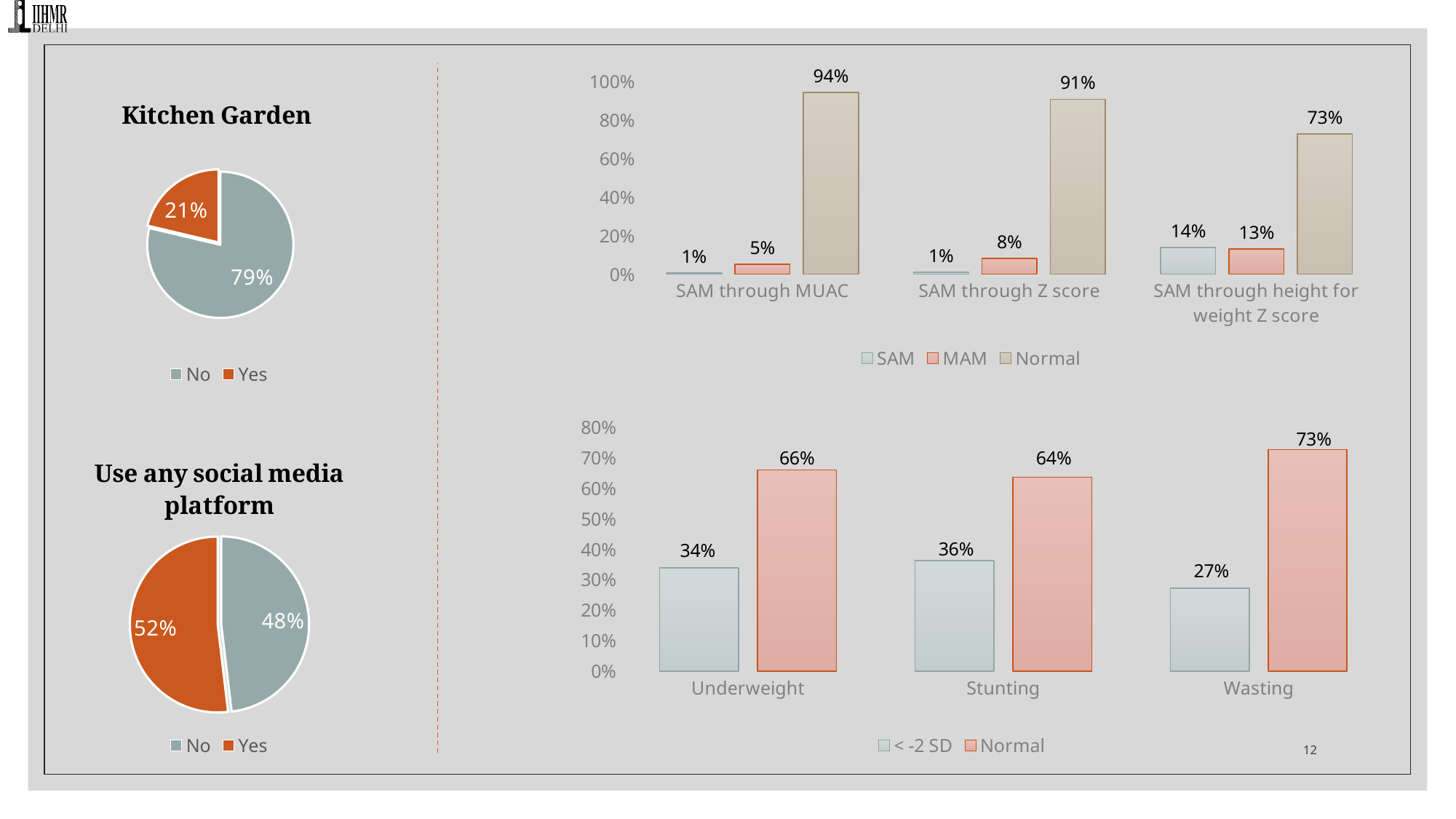
What kind of chart is the bottom-right chart? Bar chart In the top-right bar chart, what is the SAM value for SAM through height for weight Z score? 14% In the bottom-right bar chart, which category has the highest Normal value? Wasting In the top-right bar chart, what is the Normal value for SAM through MUAC? 94% In the top-right bar chart, what is the difference between the Normal values for SAM through MUAC and SAM through height for weight Z score? 21% In the 'Use any social media platform' pie chart, what share answered Yes? 52% In the Kitchen Garden pie chart, what share of respondents answered No? 79% In the bottom-right bar chart, what is the < -2 SD value for Stunting? 36% In the 'Use any social media platform' pie chart, which answer has the larger share, No or Yes? Yes In the top-right bar chart, what is the MAM value for SAM through Z score? 8% In the top-right bar chart, how many series does the legend list? 3 In the Kitchen Garden pie chart, what share of respondents answered Yes? 21%